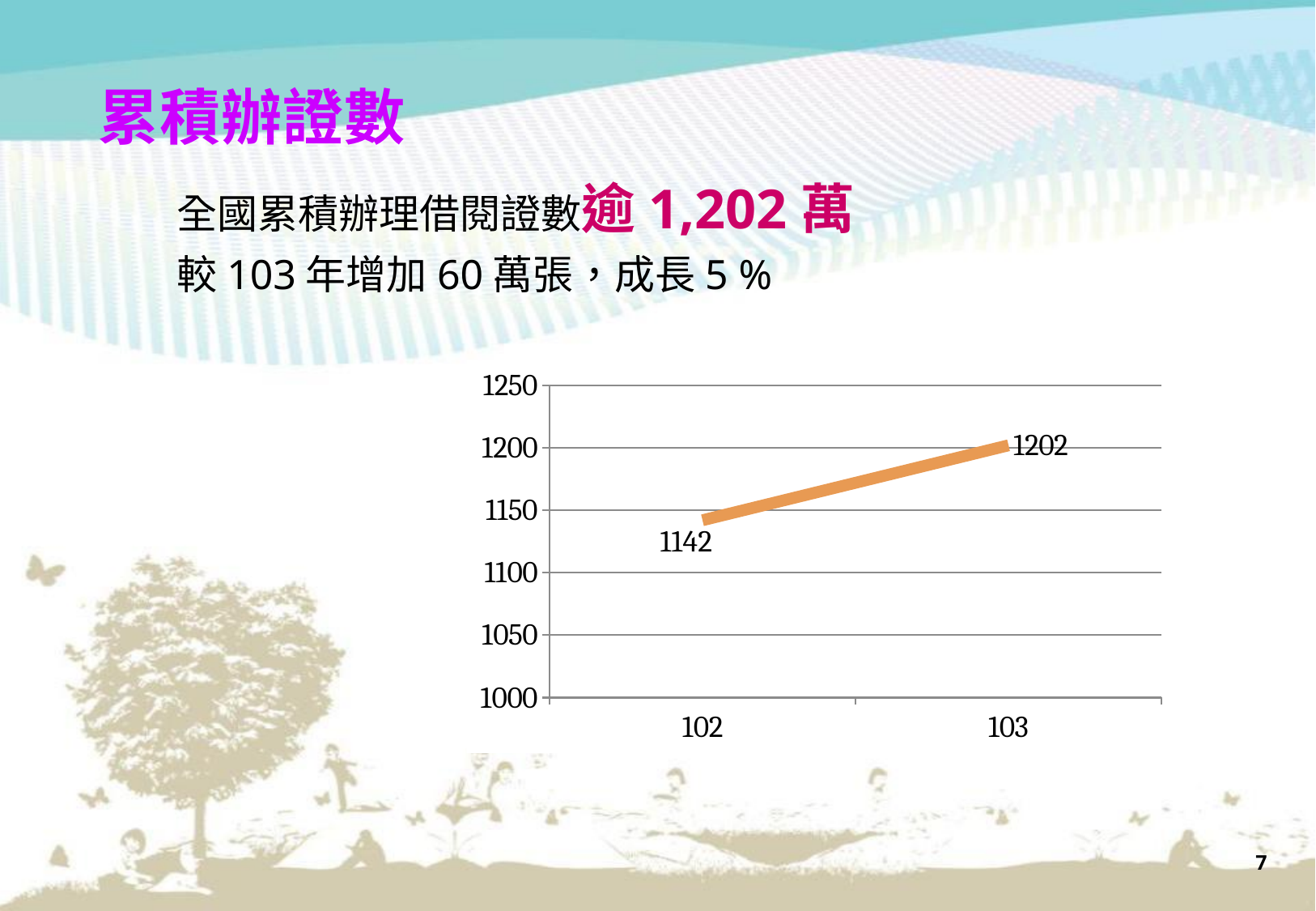
What is the value for 103 on the chart? 1202 What is the value for 102 on the chart? 1142 How many data points are plotted on the chart? 2 Which category has the lowest value on the chart? 102 What kind of chart is shown on the slide? line chart Which is larger, the value for 102 or the value for 103? 103 What colour is the line on the chart? orange Do the values rise or fall from 102 to 103? rise What is the difference between the values for 103 and 102? 60 Which category has the highest value on the chart? 103 Is the value for 102 greater or less than 1150? less Is the value for 103 greater or less than 1200? greater